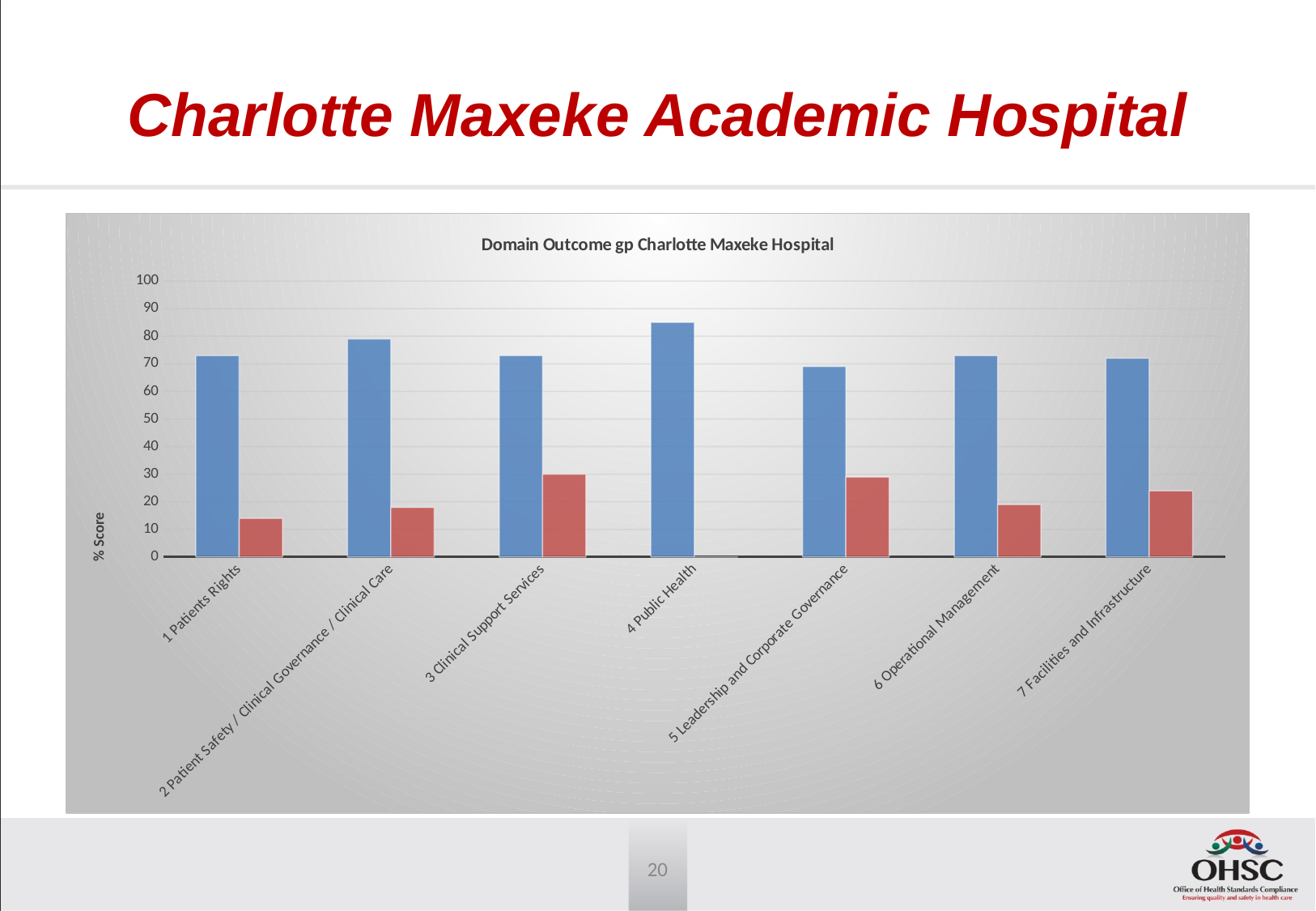
Is the blue bar for 2 Patient Safety / Clinical Governance / Clinical Care greater or less than 70? greater What is the title of the chart? Domain Outcome gp Charlotte Maxeke Hospital Which is larger, the blue bar for 4 Public Health or the blue bar for 2 Patient Safety / Clinical Governance / Clinical Care? 4 Public Health What is the label on the vertical axis of the chart? % Score Which category has the highest blue bar? 4 Public Health What kind of chart is shown on the slide? bar chart Is the red bar for 1 Patients Rights greater or less than 20? less Is the blue bar for 4 Public Health greater or less than 80? greater Which is larger, the red bar for 3 Clinical Support Services or the red bar for 1 Patients Rights? 3 Clinical Support Services How many domain categories are shown on the x axis of the chart? 7